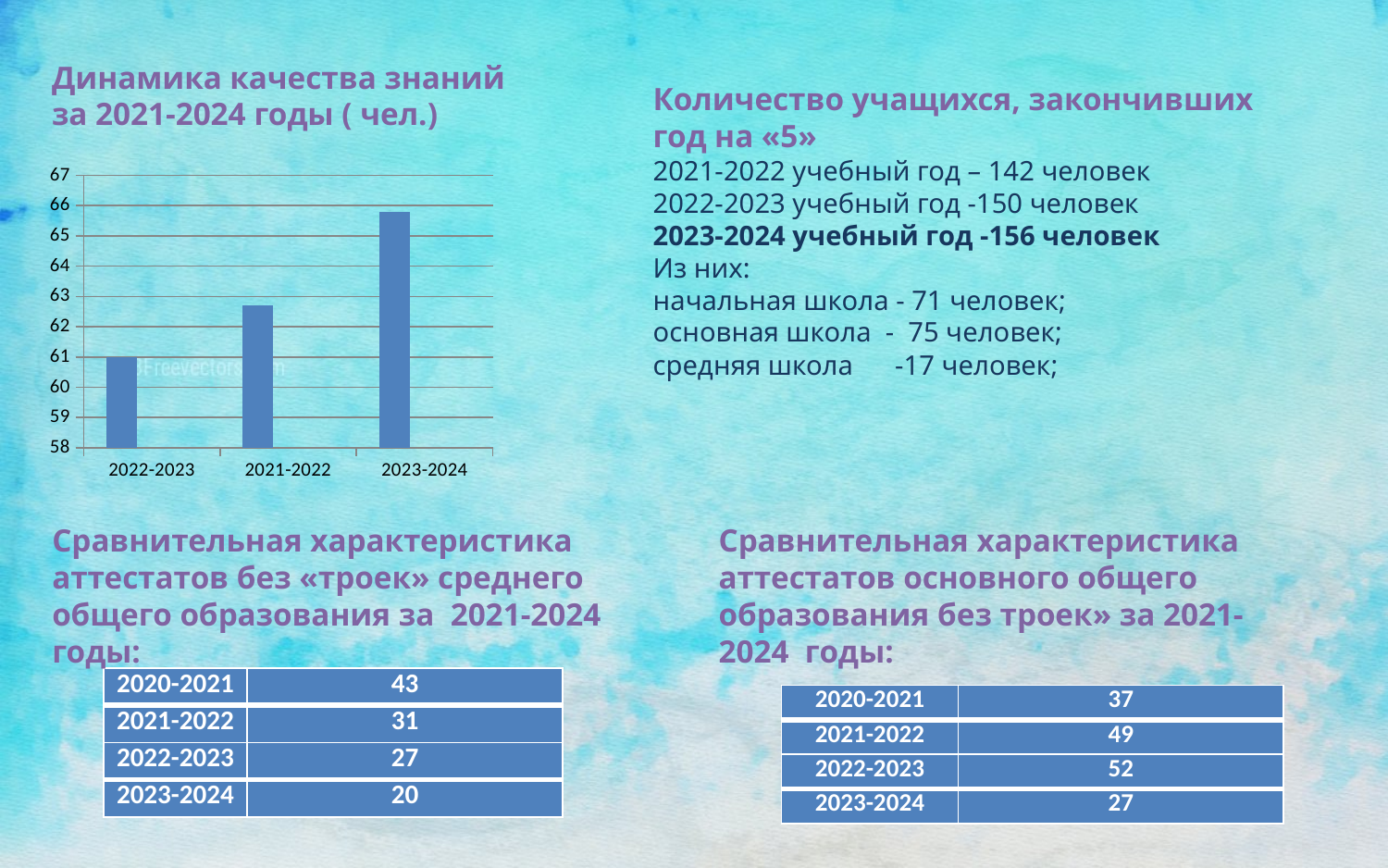
Is the value for 2023-2024 greater or less than 65? greater Which bar is taller, 2021-2022 or 2022-2023? 2021-2022 What is the label of the first category on the x axis of the chart? 2022-2023 Is the value for 2023-2024 greater or less than 64? greater What is the title of the chart? Динамика качества знаний за 2021-2024 годы ( чел.) Which category has the lowest bar in the chart? 2022-2023 Is the value for 2022-2023 greater or less than 62? less Which category has the highest bar in the chart? 2023-2024 Do the bar values rise or fall from left to right along the x axis? rise What kind of chart is shown on the slide? bar chart How many bars are plotted in the chart? 3